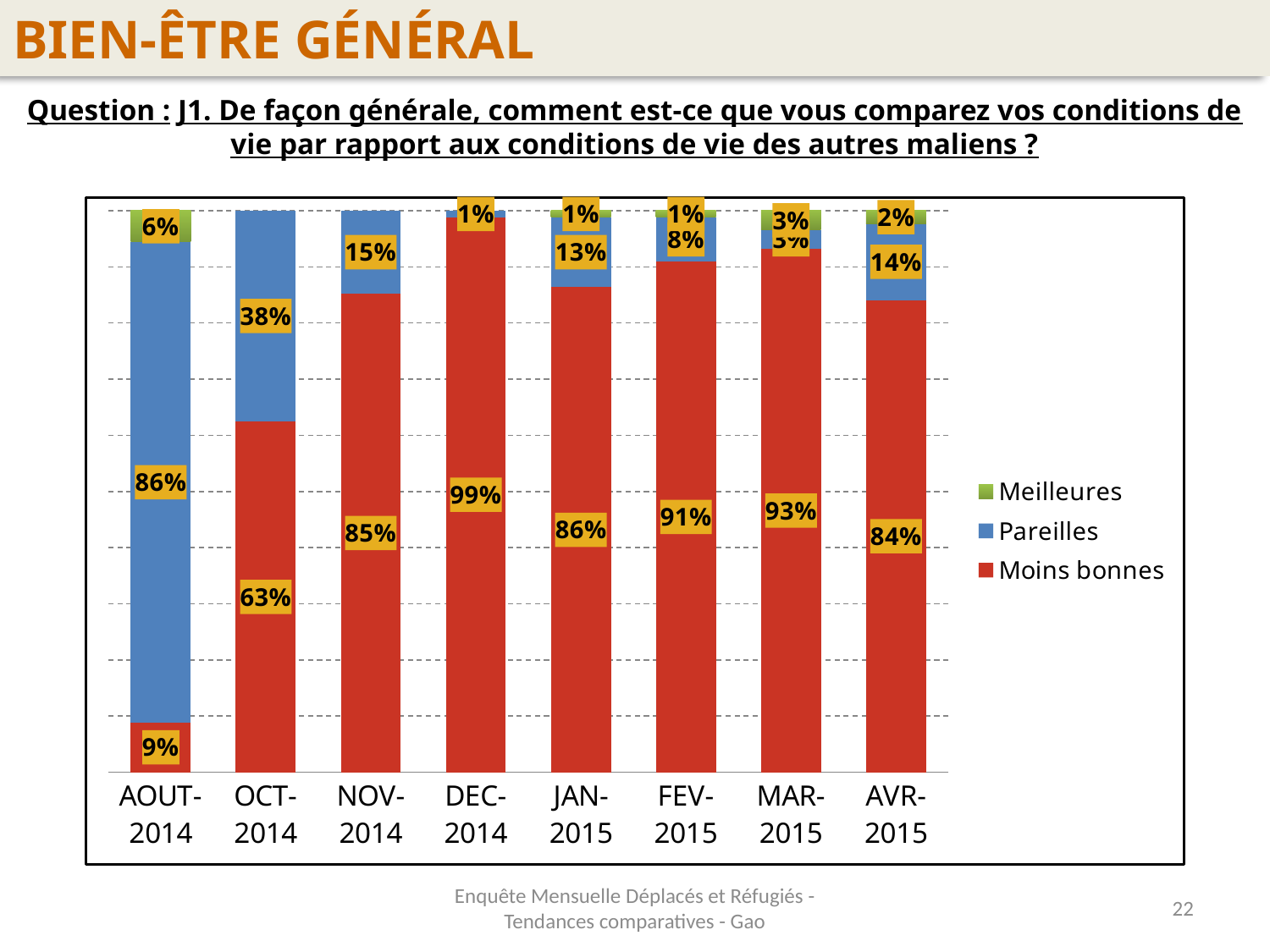
What is the value for Pareilles in OCT-2014? 38% What is the difference between the Moins bonnes values for OCT-2014 and AOUT-2014? 54% In which month is the Moins bonnes value highest? DEC-2014 How many months are shown on the x axis? 8 What type of chart is shown on the slide? stacked bar chart Which is larger, the Pareilles value in NOV-2014 or in AVR-2015? NOV-2014 How many series does the legend list? 3 What is the value for Pareilles in AOUT-2014? 86% What is the value for Moins bonnes in DEC-2014? 99% In which month is the Moins bonnes value lowest? AOUT-2014 What is the value for Meilleures in AVR-2015? 2% Which series is shown in red? Moins bonnes